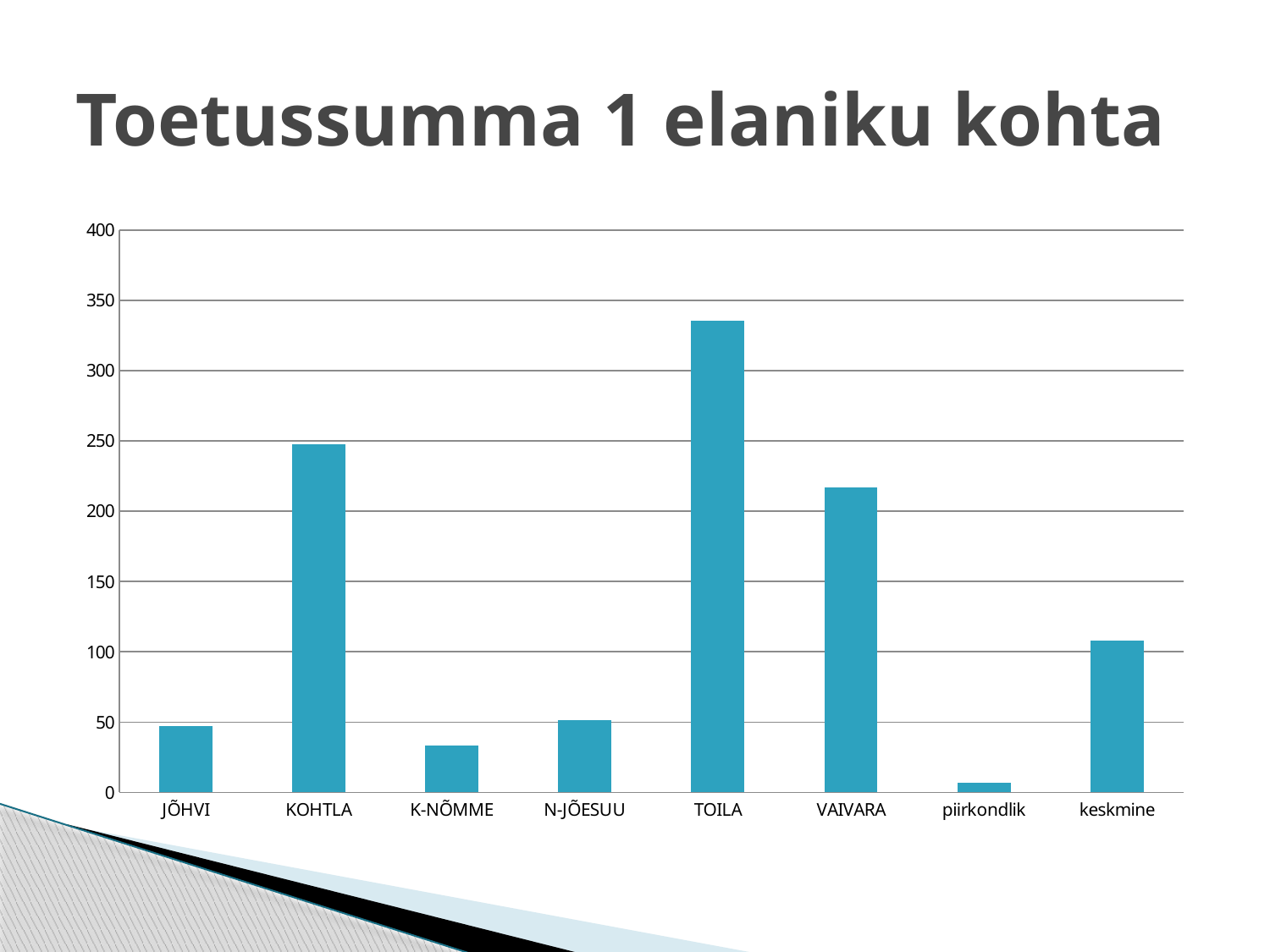
Is the value for keskmine greater or less than 100? greater What kind of chart is shown on the slide? bar chart Which is larger, the value for JÕHVI or the value for N-JÕESUU? N-JÕESUU Is the value for K-NÕMME greater or less than 50? less Which is larger, the value for KOHTLA or the value for VAIVARA? KOHTLA Is the value for KOHTLA greater or less than 200? greater What is the title of the slide containing the chart? Toetussumma 1 elaniku kohta Which category has the highest value in the chart? TOILA Which category has the lowest value in the chart? piirkondlik How many categories are shown on the x axis of the chart? 8